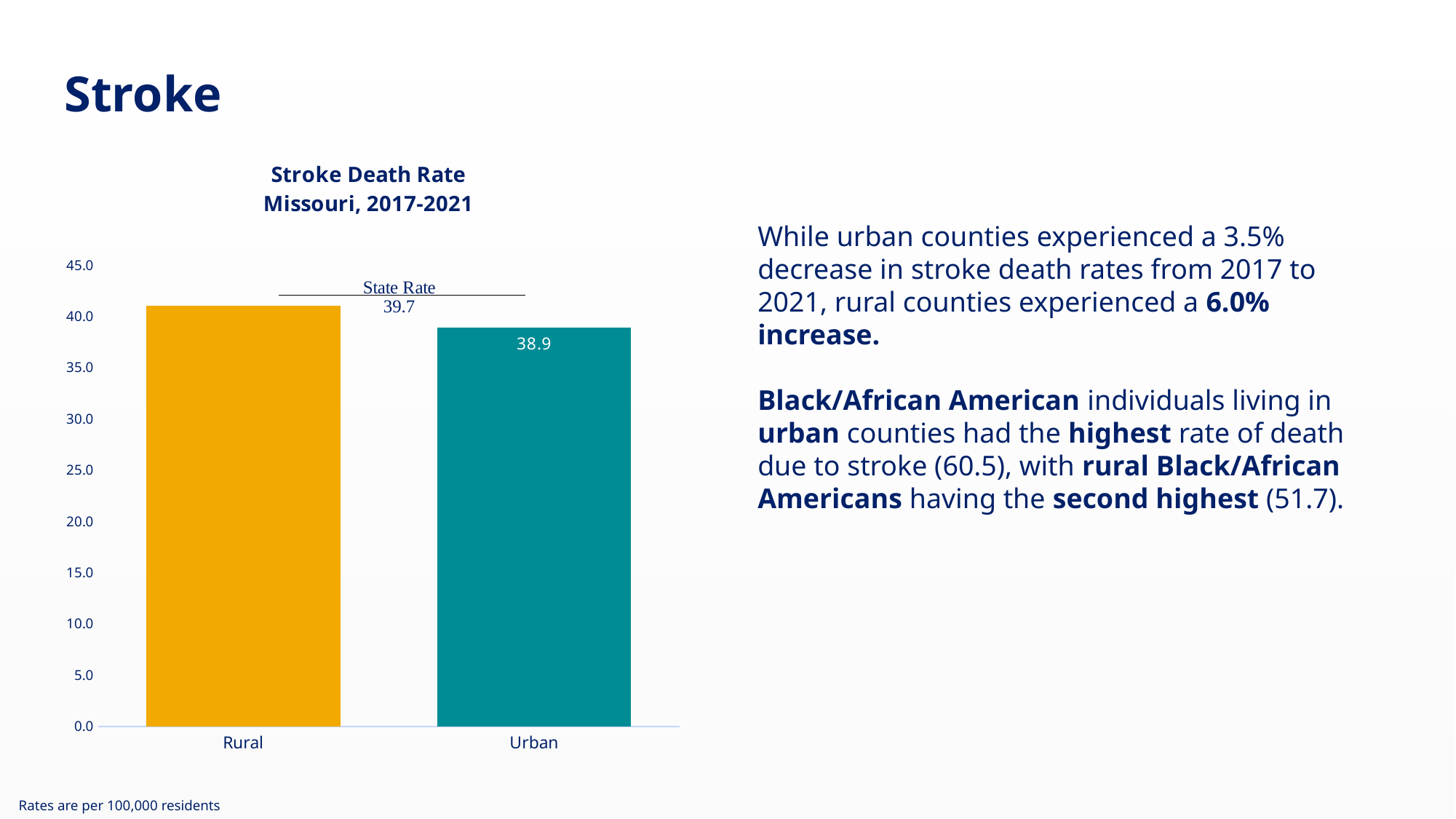
Is the value for Rural greater or less than 40.0? greater What is the stroke death rate for Urban counties shown on the chart? 38.9 Is the Urban stroke death rate greater or less than the State Rate? less Which category has the higher stroke death rate, Rural or Urban? Rural Which category has the highest stroke death rate on the chart? Rural Which category has the lowest stroke death rate on the chart? Urban What is the State Rate shown on the chart? 39.7 How many categories are plotted on the chart? 2 What is the difference between the State Rate and the Urban stroke death rate? 0.8 What type of chart is shown on the slide? Bar chart Is the value for Urban greater or less than 40.0? less What is the title of the chart? Stroke Death Rate Missouri, 2017-2021